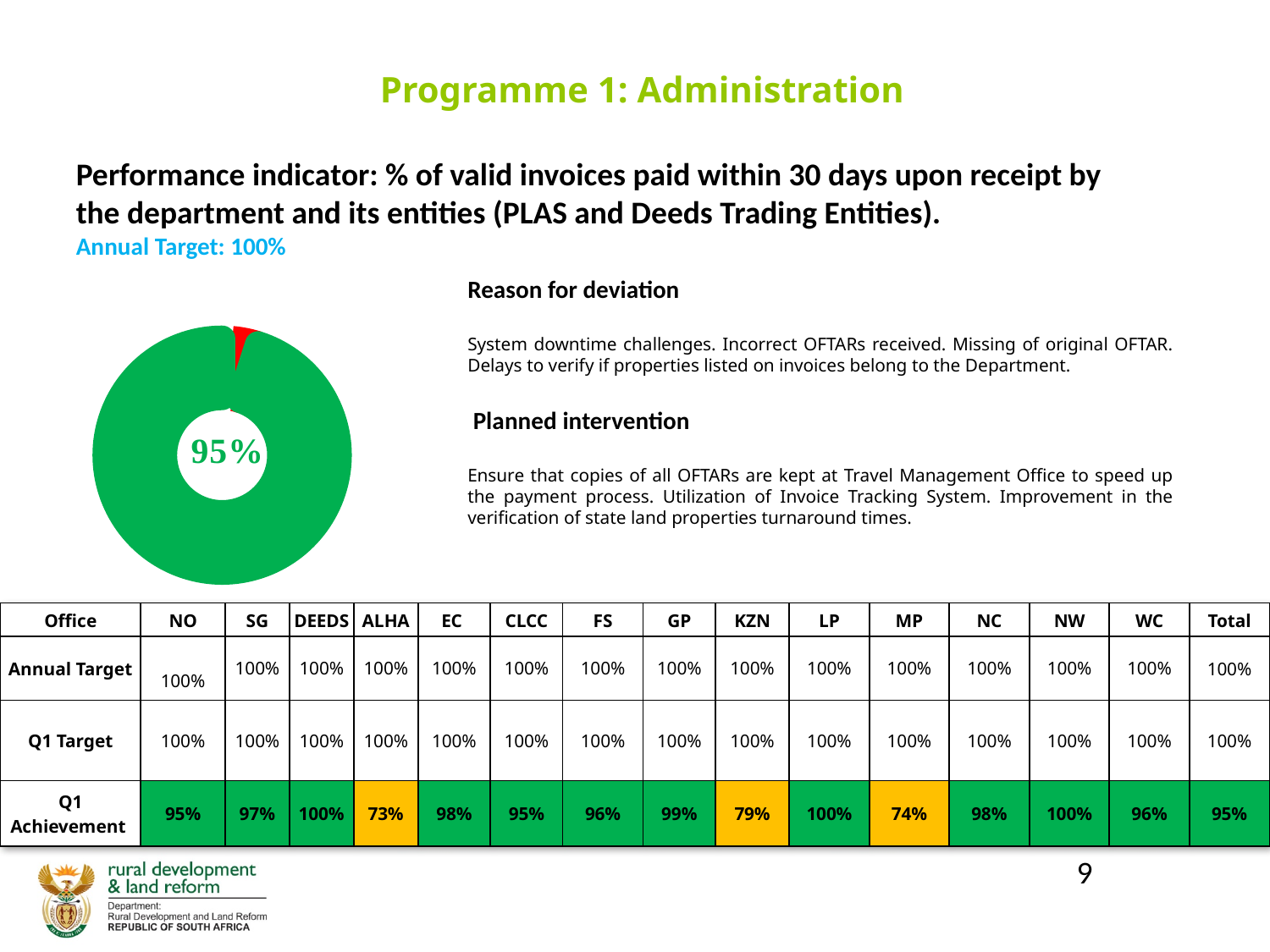
Which slice of the doughnut chart is larger, the green one or the red one? green What colour is the small slice at the top of the doughnut chart? red Which slice of the doughnut chart is the smallest? the red slice How many slices does the doughnut chart have? 2 What percentage is printed in the centre of the doughnut chart? 95% What kind of chart is shown on the left of the slide? doughnut chart What share of the doughnut chart does the green slice represent? 95% Is the value shown in the doughnut chart greater or less than 50%? greater What colour is the largest slice of the doughnut chart? green